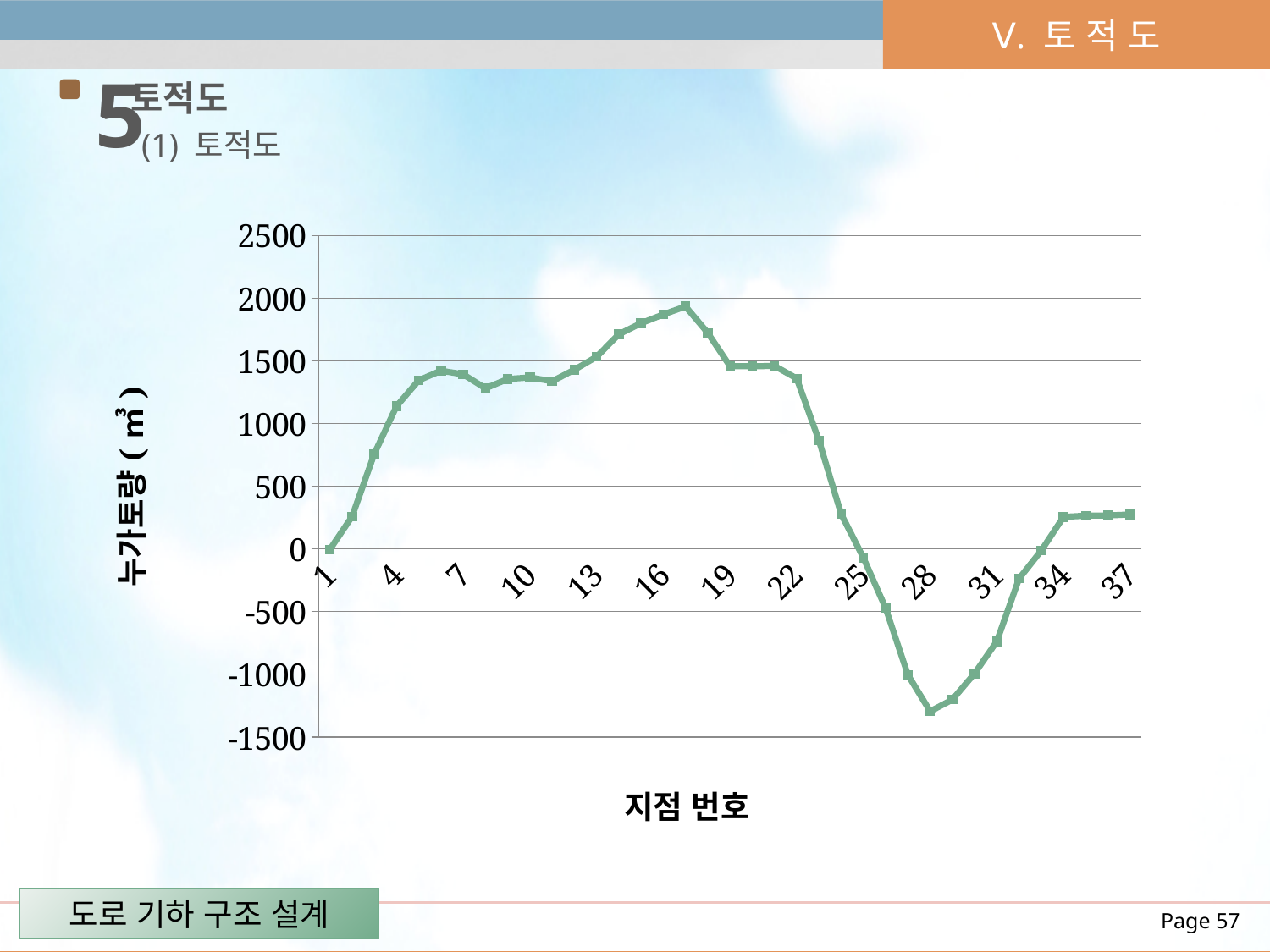
At which 지점 번호 does the line reach its lowest value? 28 Which has the larger value, 지점 번호 4 or 지점 번호 31? 지점 번호 4 What kind of chart is shown on the slide? line chart Is the value at 지점 번호 28 greater or less than -1000? less Does the line rise or fall between 지점 번호 19 and 지점 번호 28? fall Is the value at 지점 번호 37 greater or less than 500? less Is the value at 지점 번호 17 greater or less than 2000? less What is the title of the y axis of the chart? 누가토량 (㎥) At which 지점 번호 does the line reach its highest value? 17 What is the title of the x axis of the chart? 지점 번호